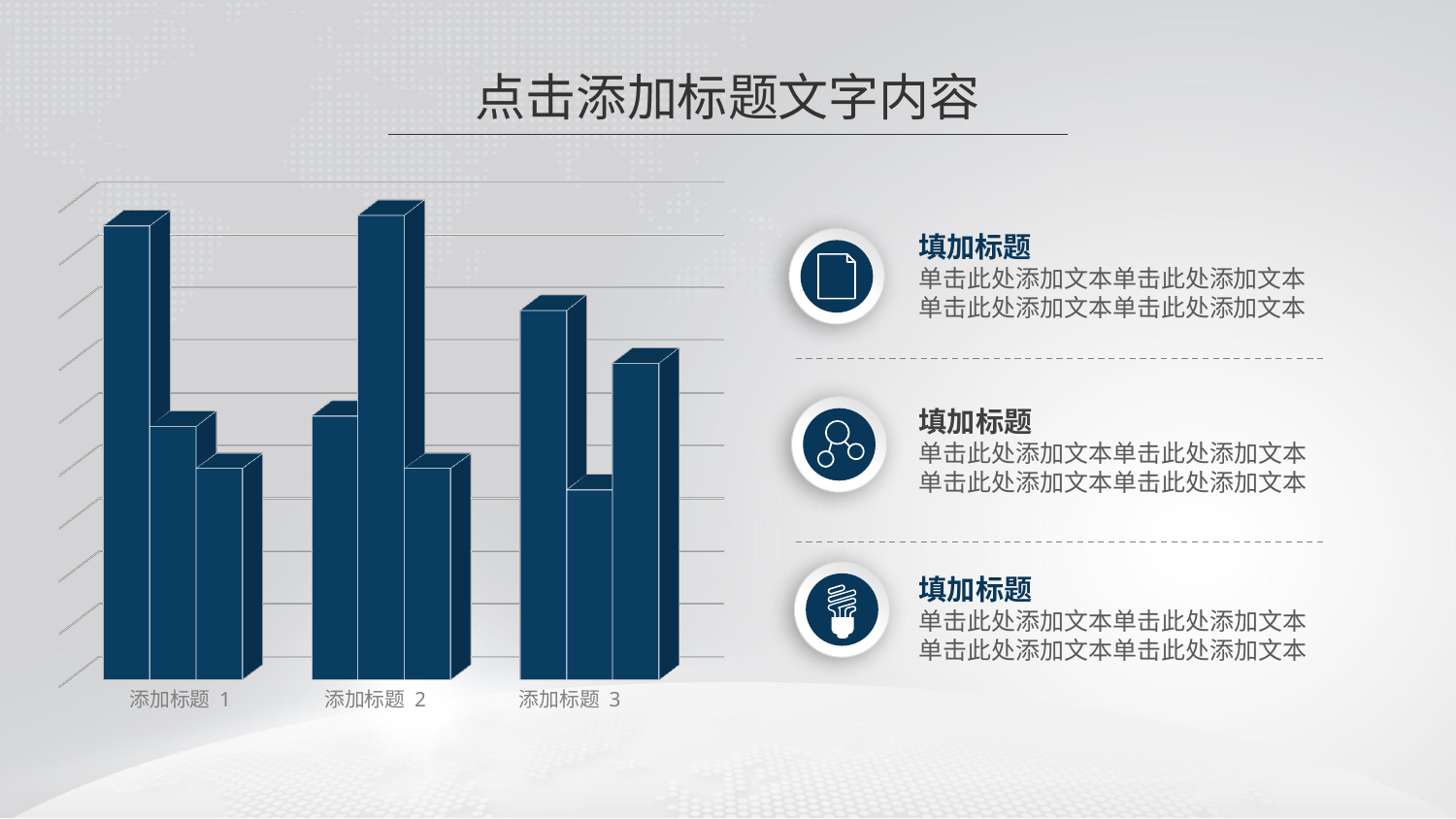
Within the category 添加标题 2, which bar is the tallest: the left, middle or right one? middle Does the chart display a legend? No How many categories are shown on the x axis of the chart? 3 Which is taller: the left bar of 添加标题 3 or the right bar of 添加标题 3? the left bar Which is taller: the left bar of 添加标题 1 or the left bar of 添加标题 2? the left bar of 添加标题 1 Within the category 添加标题 1, do the bars rise or fall from left to right? fall Which category contains the shortest bar in the chart? 添加标题 3 Within the category 添加标题 3, which bar is the shortest: the left, middle or right one? middle What kind of chart is shown on the left of the slide? bar chart Which category contains the tallest bar in the chart? 添加标题 2 What colour are the bars in the chart? dark blue How many bars are plotted for each category in the chart? 3